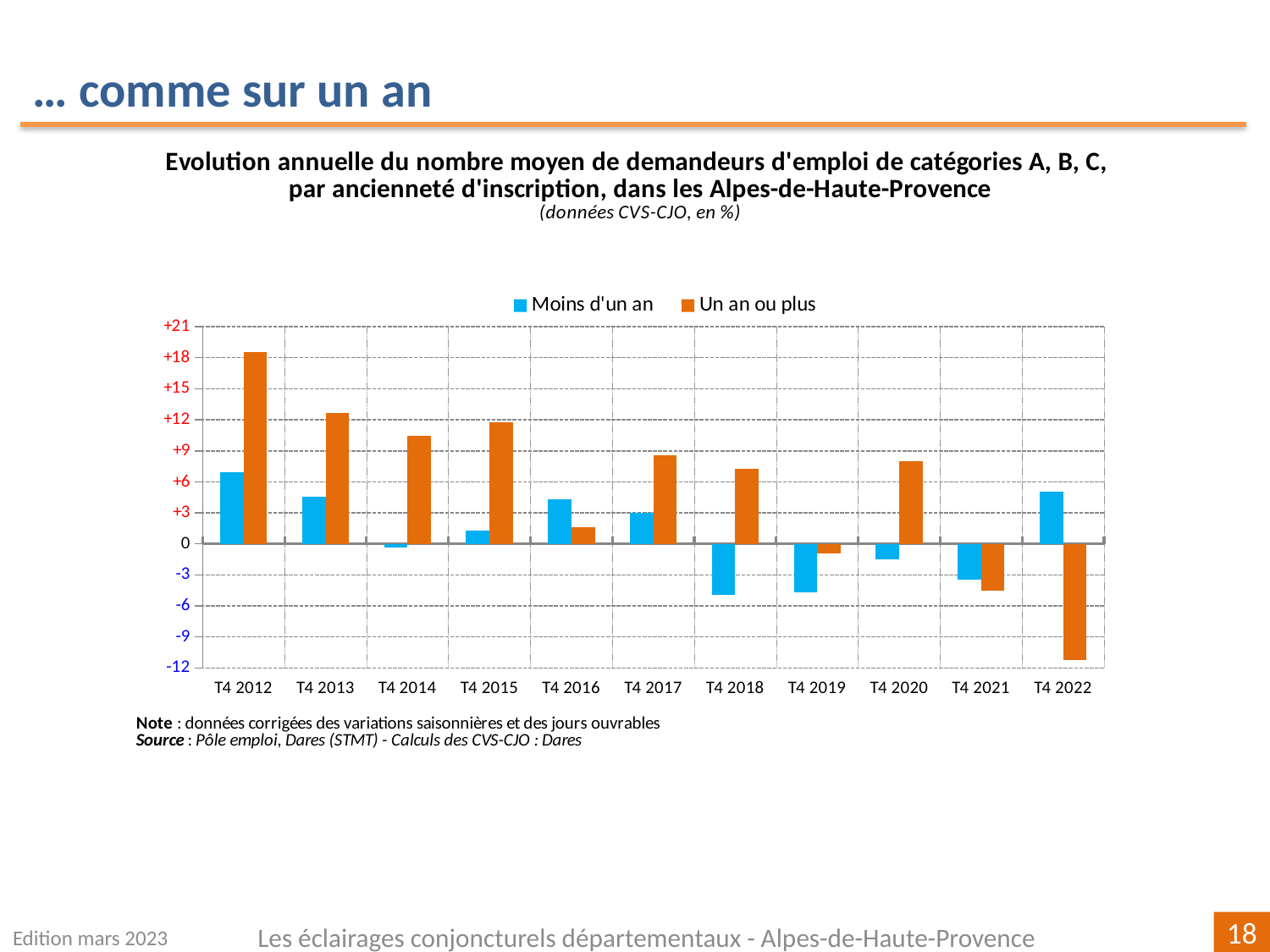
In T4 2016, which series has the larger value, 'Moins d'un an' or 'Un an ou plus'? Moins d'un an For which period is the value of 'Un an ou plus' the lowest? T4 2022 For which period is the value of 'Un an ou plus' the highest? T4 2012 Is the value of 'Un an ou plus' for T4 2012 greater or less than +15? greater What kind of chart is shown on the slide? bar chart Which series are listed in the legend? Moins d'un an; Un an ou plus How many series does the legend list? 2 In T4 2012, which series has the larger value, 'Moins d'un an' or 'Un an ou plus'? Un an ou plus Is the value of 'Moins d'un an' for T4 2018 greater or less than -3? less For which period is the value of 'Moins d'un an' the highest? T4 2012 Is the value of 'Un an ou plus' for T4 2022 greater or less than -9? less How many periods (categories) are shown on the x axis? 11